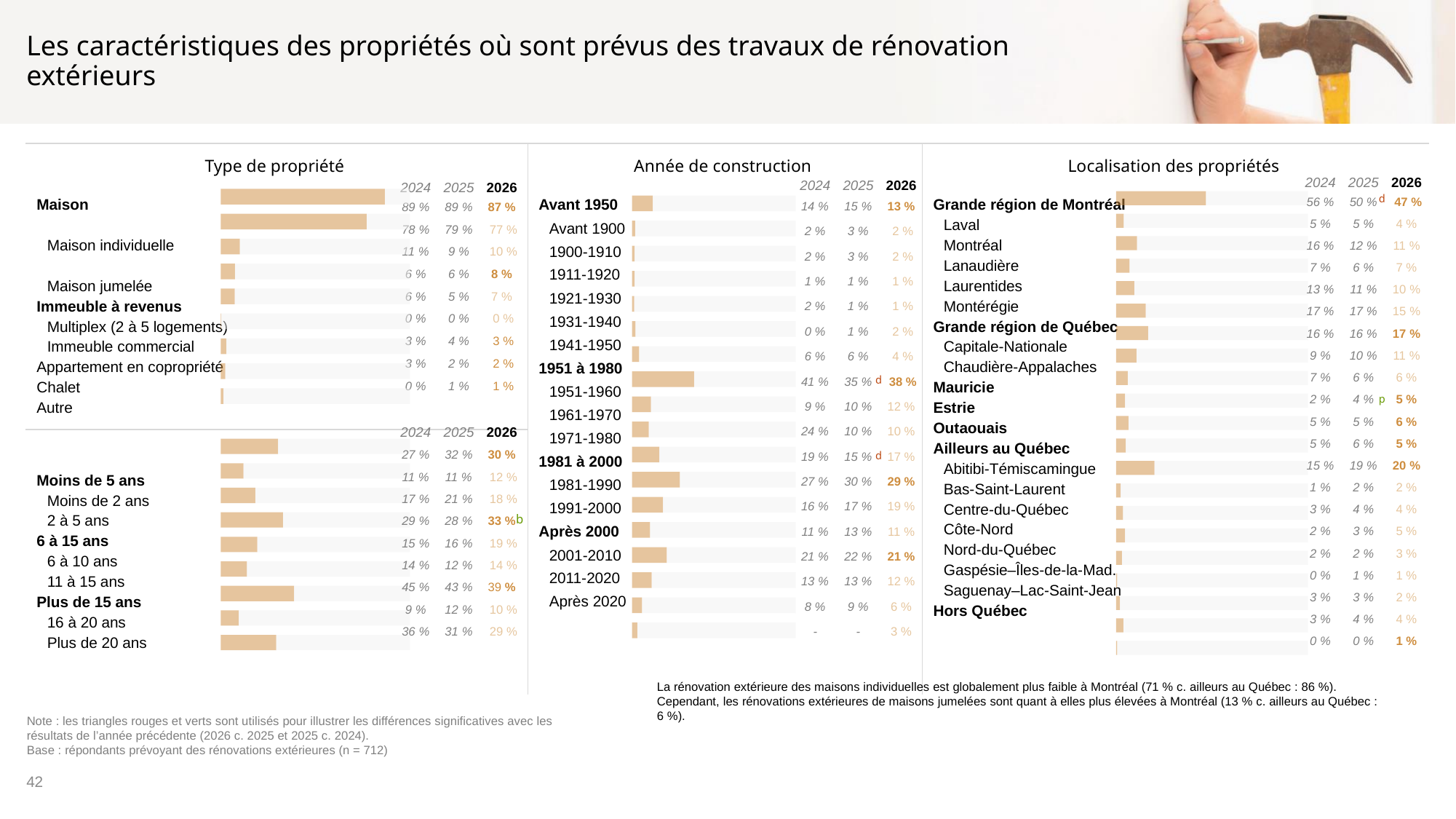
How many years of results are shown in the columns of each panel? 3 (2024, 2025, 2026) In the 'Année de construction' chart, what is the 2026 value for Avant 1950? 13 % In the 'Localisation des propriétés' chart, what was the 2024 value for Grande région de Montréal? 56 % Which is larger in 2026: Maison in the 'Type de propriété' chart or Grande région de Montréal in the 'Localisation des propriétés' chart? Maison In the 'Type de propriété' chart, what was the value for Maison in 2024? 89 % In the 'Localisation des propriétés' chart, what is the 2026 value for Grande région de Montréal? 47 % In the 'Type de propriété' chart, is the 2026 value for Maison greater or less than 50 %? greater In the 'Localisation des propriétés' chart, which category has the highest 2026 value? Grande région de Montréal In the 'Localisation des propriétés' chart, by how many percentage points did Grande région de Montréal fall from 2024 to 2026? 9 points What kind of chart is used in the three panels of this slide? Bar chart In the 'Type de propriété' chart, what is the 2026 value for Maison? 87 % In the 'Année de construction' chart, which category has the longest bar (highest 2026 value)? 1951 à 1980